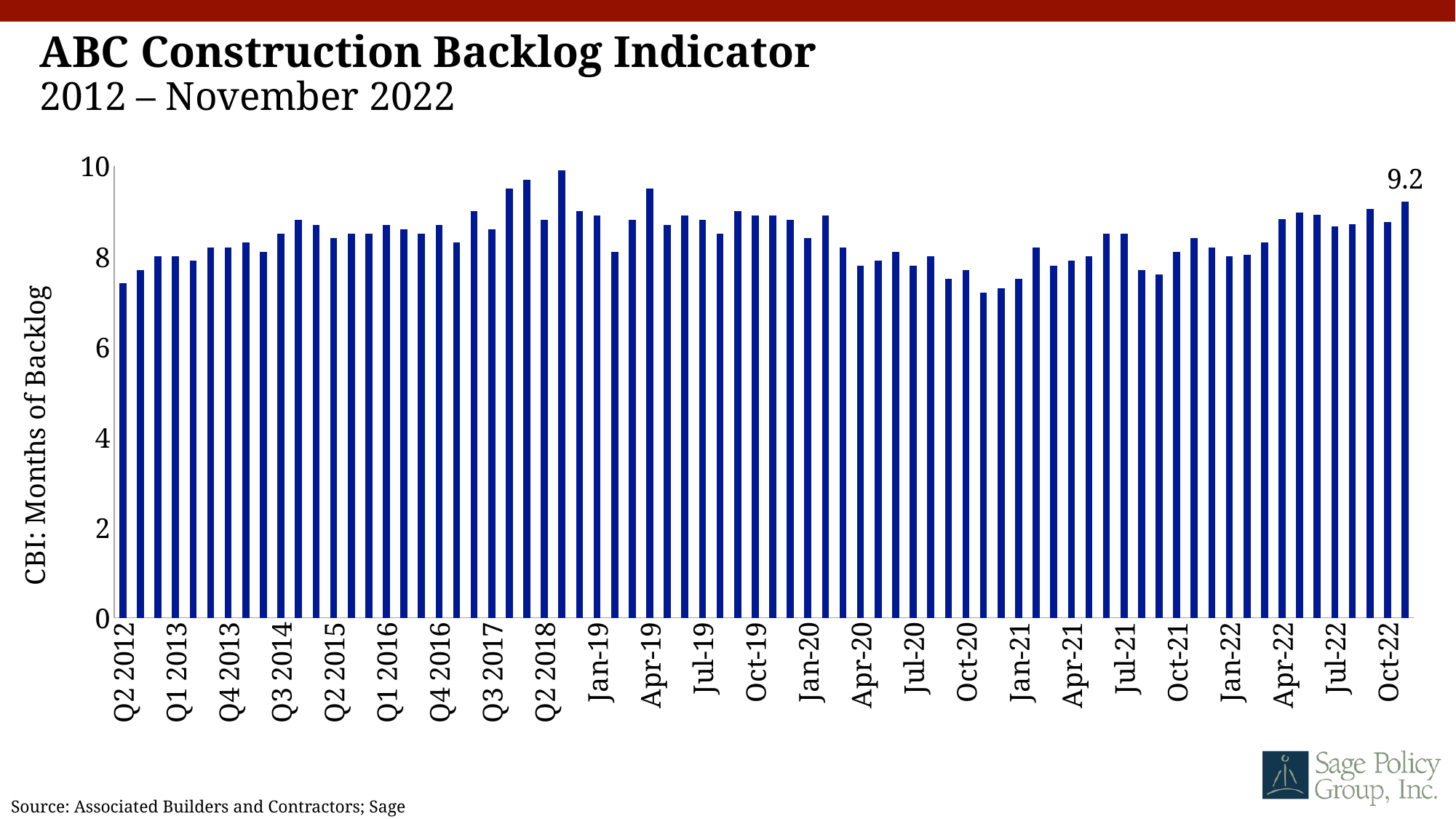
Is the value for Apr-19 greater or less than 8? greater What type of chart is shown on the slide? bar chart Is the value for Oct-20 greater or less than 8? less Is the value for Jan-19 greater or less than 8? greater Do the values generally rise or fall from Q2 2012 to Q2 2018? rise What is the value of the last bar (November 2022) in the ABC Construction Backlog Indicator chart? 9.2 Which is larger, the value for Q2 2018 or the value for Q2 2012? Q2 2018 Which is larger, the value for Apr-19 or the value for Oct-20? Apr-19 What is the title of the chart on the slide? ABC Construction Backlog Indicator What is the label on the vertical axis of the chart? CBI: Months of Backlog